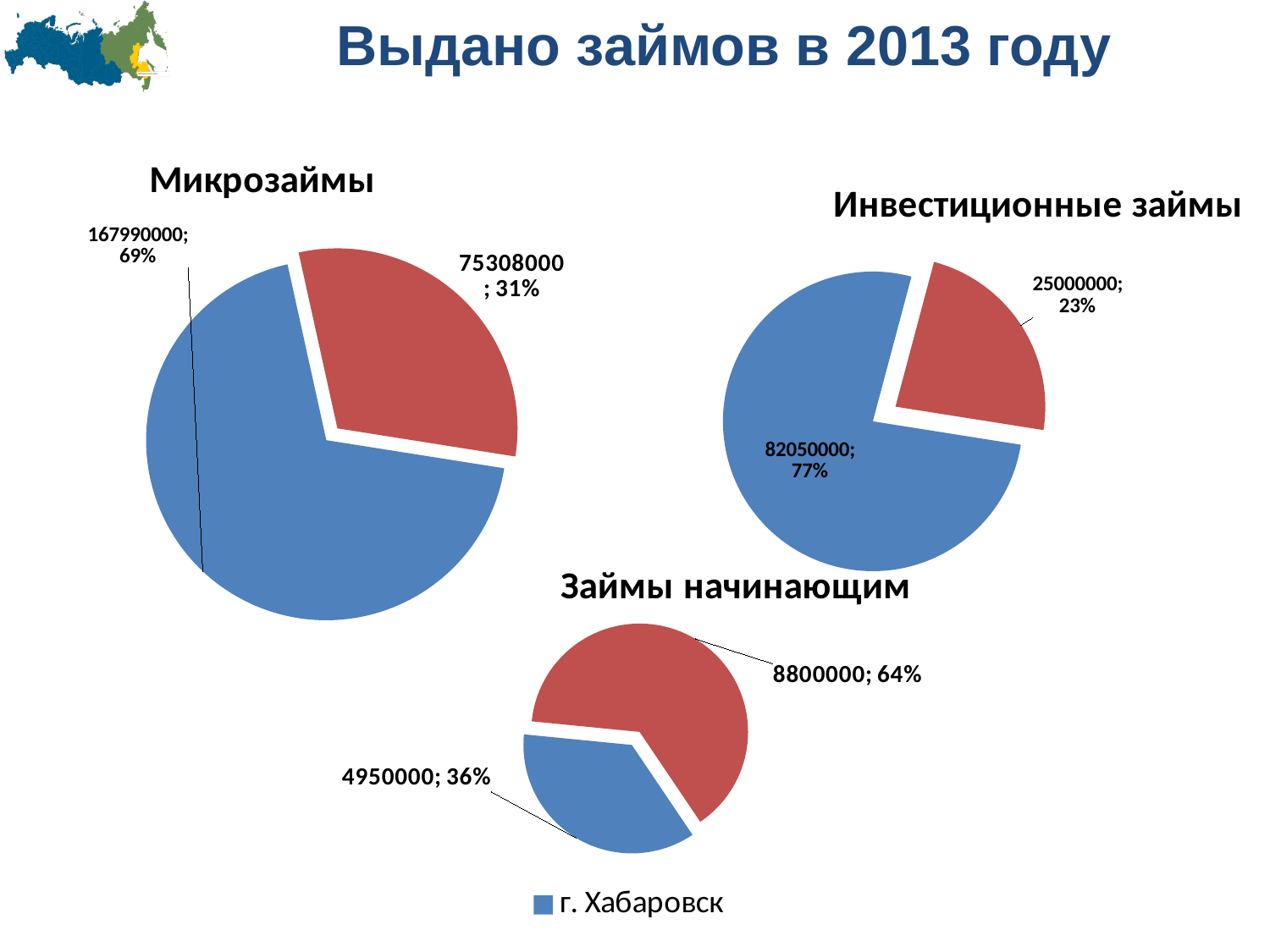
In the "Инвестиционные займы" chart, what share of the pie does the red slice have? 23% In the "Займы начинающим" chart, which slice is larger, the blue one or the red one? the red one In the "Микрозаймы" chart, what share of the pie does the red slice have? 31% In the "Займы начинающим" chart, what share of the pie does the blue slice (г. Хабаровск) have? 36% How many slices does the "Инвестиционные займы" pie chart have? 2 In the "Инвестиционные займы" chart, what is the total of the two slice values? 107050000 In the "Инвестиционные займы" chart, what value is shown for the blue slice (г. Хабаровск)? 82050000 What is the only entry shown in the legend at the bottom of the slide? г. Хабаровск What kind of chart is the "Микрозаймы" chart? pie chart In the "Микрозаймы" chart, what is the difference between the blue slice value and the red slice value? 92682000 In the "Микрозаймы" chart, what value is shown for the blue slice (г. Хабаровск)? 167990000 In the "Займы начинающим" chart, what value is shown for the red slice? 8800000